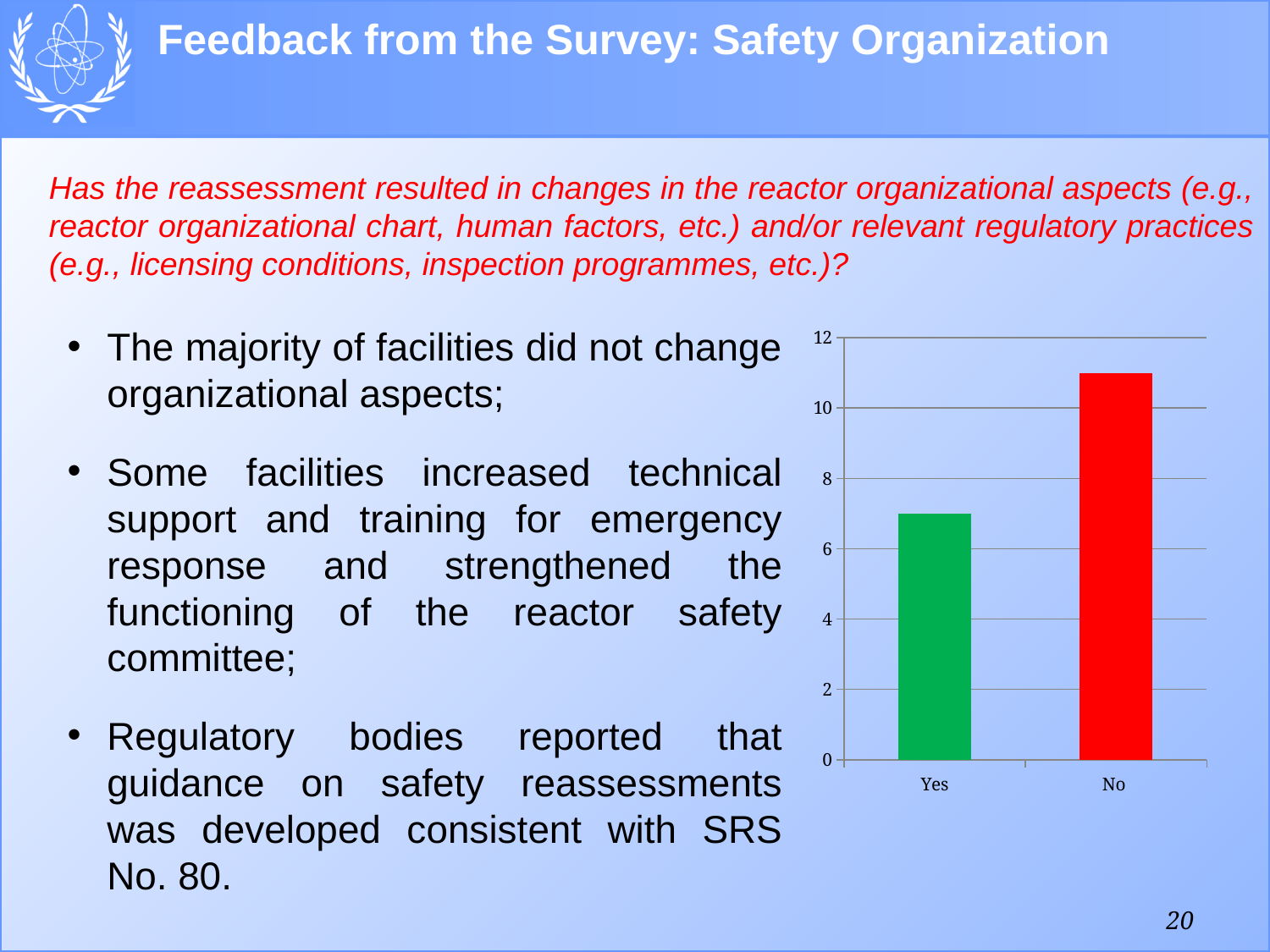
Is the value for Yes greater or less than 8? less Is the value for No greater or less than 10? greater What is the highest value shown on the y axis of the chart? 12 Do the bar values rise or fall going from Yes to No along the x axis? rise Is the value for No greater or less than 12? less What kind of chart is shown on the slide? bar chart Which category has the lowest bar in the chart? Yes What colour is the bar for the No category? red Which is larger in the chart, the value for Yes or the value for No? No Which category has the highest bar in the chart? No How many categories are shown on the x axis of the chart? 2